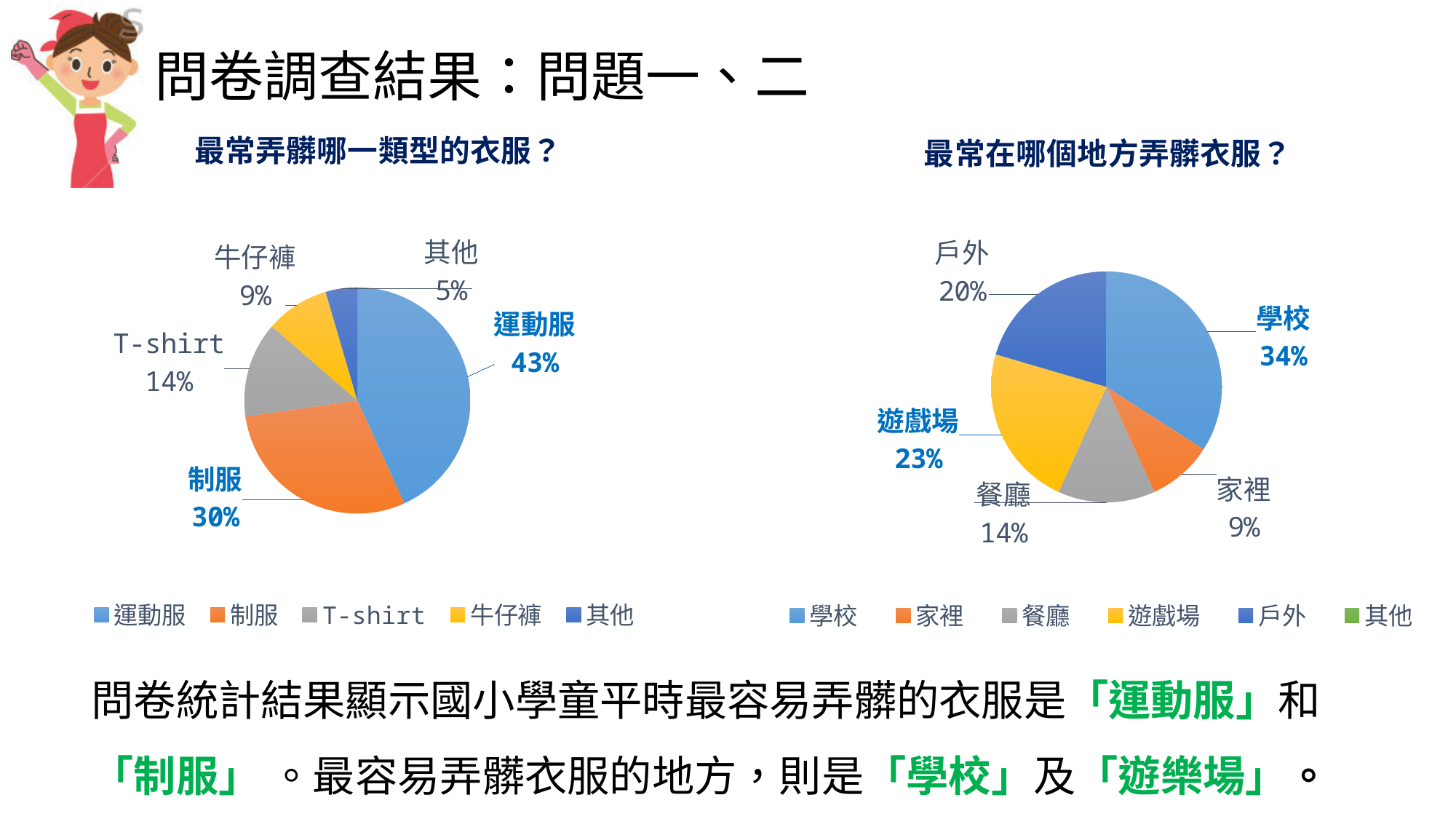
In the right chart titled 最常在哪個地方弄髒衣服？, which is larger, 遊戲場 or 餐廳? 遊戲場 In the right chart titled 最常在哪個地方弄髒衣服？, which labelled category has the smallest slice? 家裡 In the left chart titled 最常弄髒哪一類型的衣服？, how many categories does the legend list? 5 In the left chart titled 最常弄髒哪一類型的衣服？, which category has the largest slice? 運動服 In the right chart titled 最常在哪個地方弄髒衣服？, what share is labelled for 學校? 34% In the left chart titled 最常弄髒哪一類型的衣服？, what share is labelled for 運動服? 43% What type of chart is used for the left chart titled 最常弄髒哪一類型的衣服？? Pie chart In the right chart titled 最常在哪個地方弄髒衣服？, what share is labelled for 戶外? 20% In the right chart titled 最常在哪個地方弄髒衣服？, how many entries does the legend list? 6 In the left chart titled 最常弄髒哪一類型的衣服？, which category has the smallest slice? 其他 In the left chart titled 最常弄髒哪一類型的衣服？, what is the difference in percentage points between 運動服 and 制服? 13 In the left chart titled 最常弄髒哪一類型的衣服？, what share is labelled for T-shirt? 14%